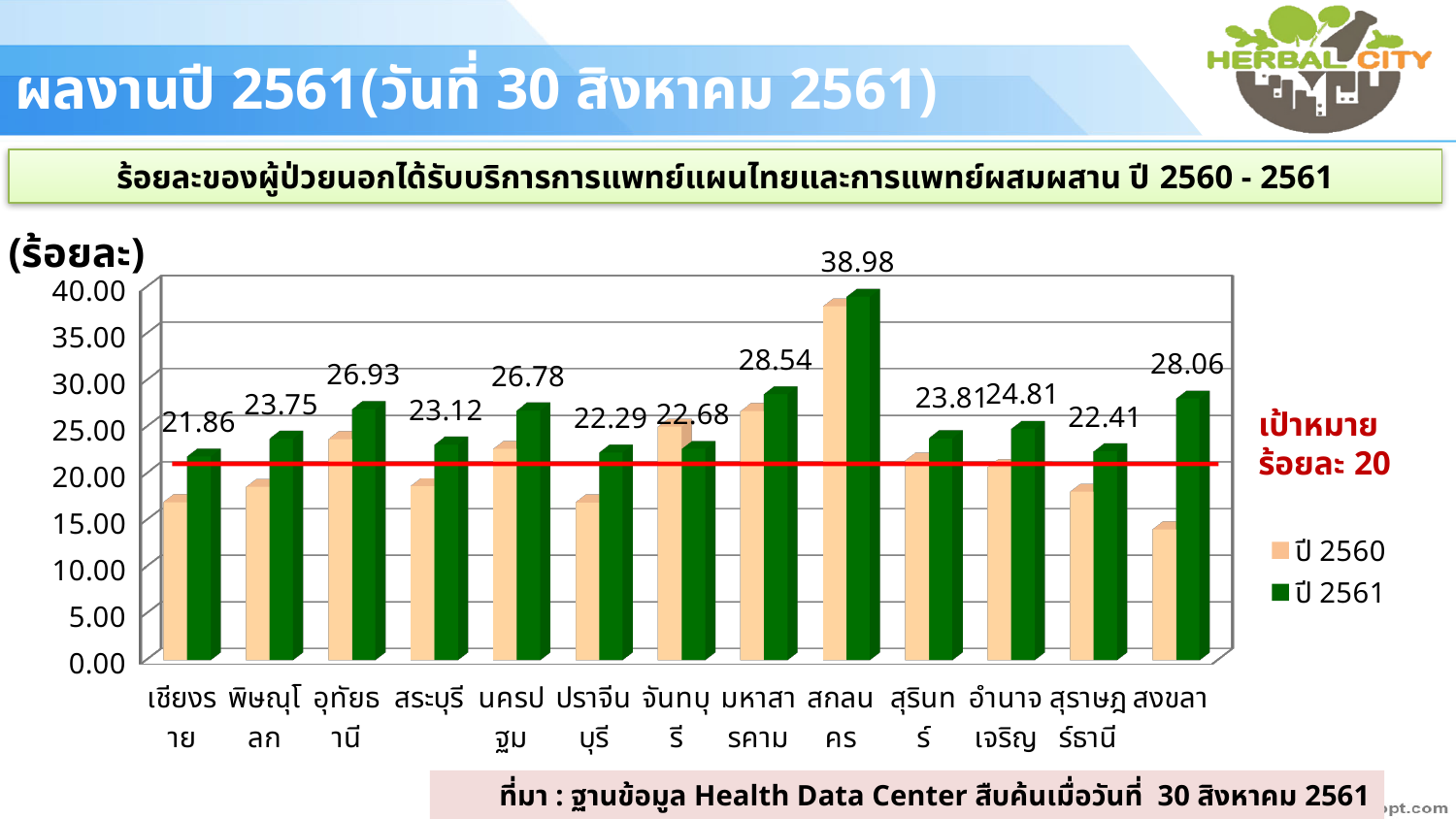
How many provinces are shown on the x axis? 13 Which province has the highest ปี 2561 value? สกลนคร Which has the larger ปี 2561 value, อุทัยธานี or สระบุรี? อุทัยธานี What type of chart is shown? bar chart What is the ปี 2561 value for มหาสารคาม? 28.54 How many series does the legend list? 2 What is the ปี 2561 value for สกลนคร? 38.98 Which province has the lowest ปี 2561 value? เชียงราย Is the ปี 2560 value for สงขลา greater or less than 20.00? less What is the ปี 2561 value for เชียงราย? 21.86 Is the ปี 2560 value for สกลนคร greater or less than 35.00? greater What is the difference between the ปี 2561 values for สกลนคร and สงขลา? 10.92